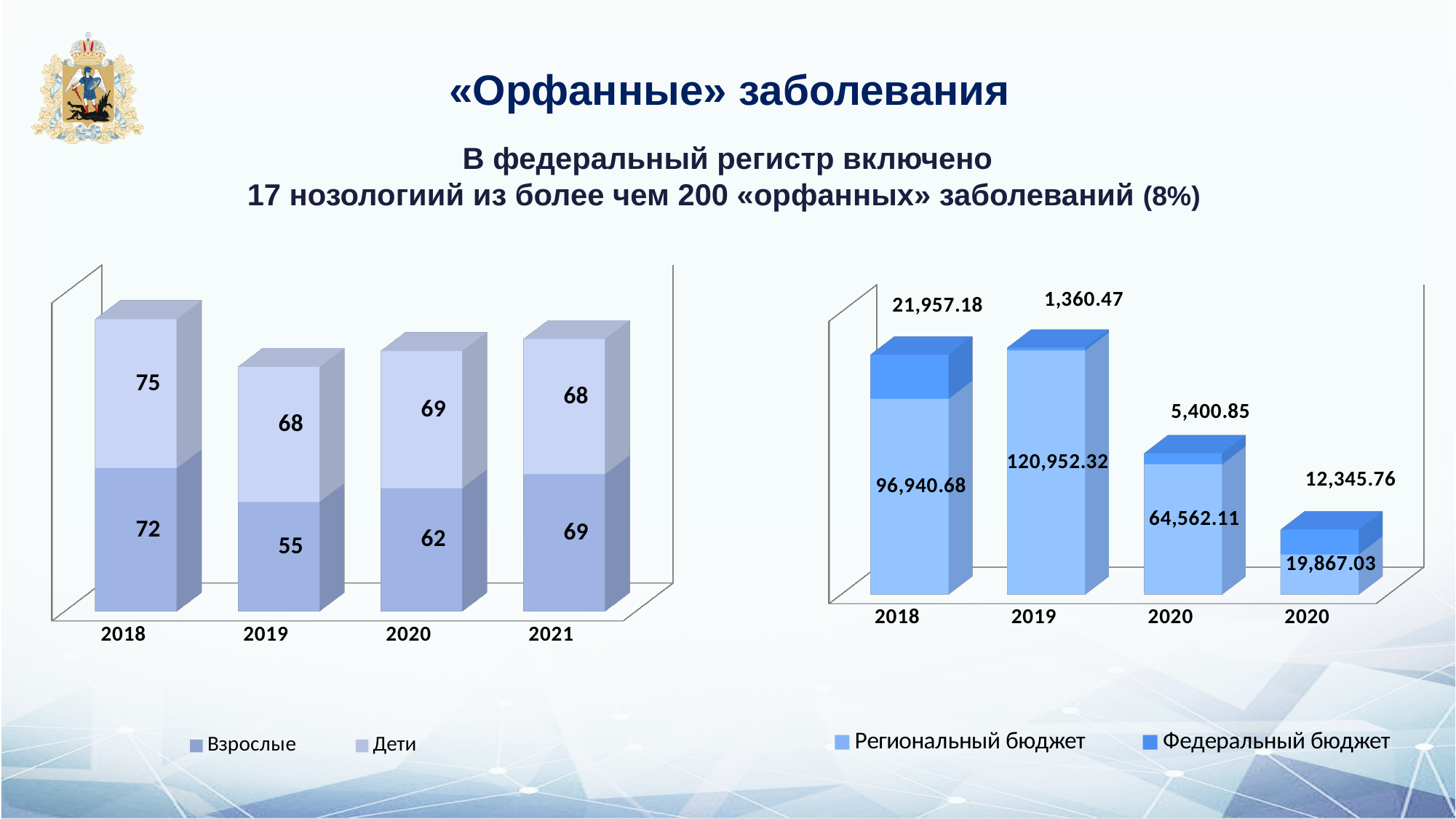
In the left chart, which year has the highest value for Взрослые? 2018 In the right chart, what is the value for Региональный бюджет in 2019? 120,952.32 In the left chart, what is the total of the stacked bar for 2018? 147 In the left chart, how many series does the legend list? 2 In the left chart, what is the value for Дети in 2018? 75 In the left chart, which year has the lowest value for Взрослые? 2019 In the right chart, is the Федеральный бюджет value for 2018 larger or smaller than the Федеральный бюджет value for 2019? larger In the left chart, what is the value for Взрослые in 2019? 55 In the right chart, which year has the highest value for Региональный бюджет? 2019 In the right chart, what is the value for Федеральный бюджет in 2018? 21,957.18 In the left chart, what is the difference between Дети and Взрослые in 2020? 7 What kind of chart is the right chart? stacked bar chart